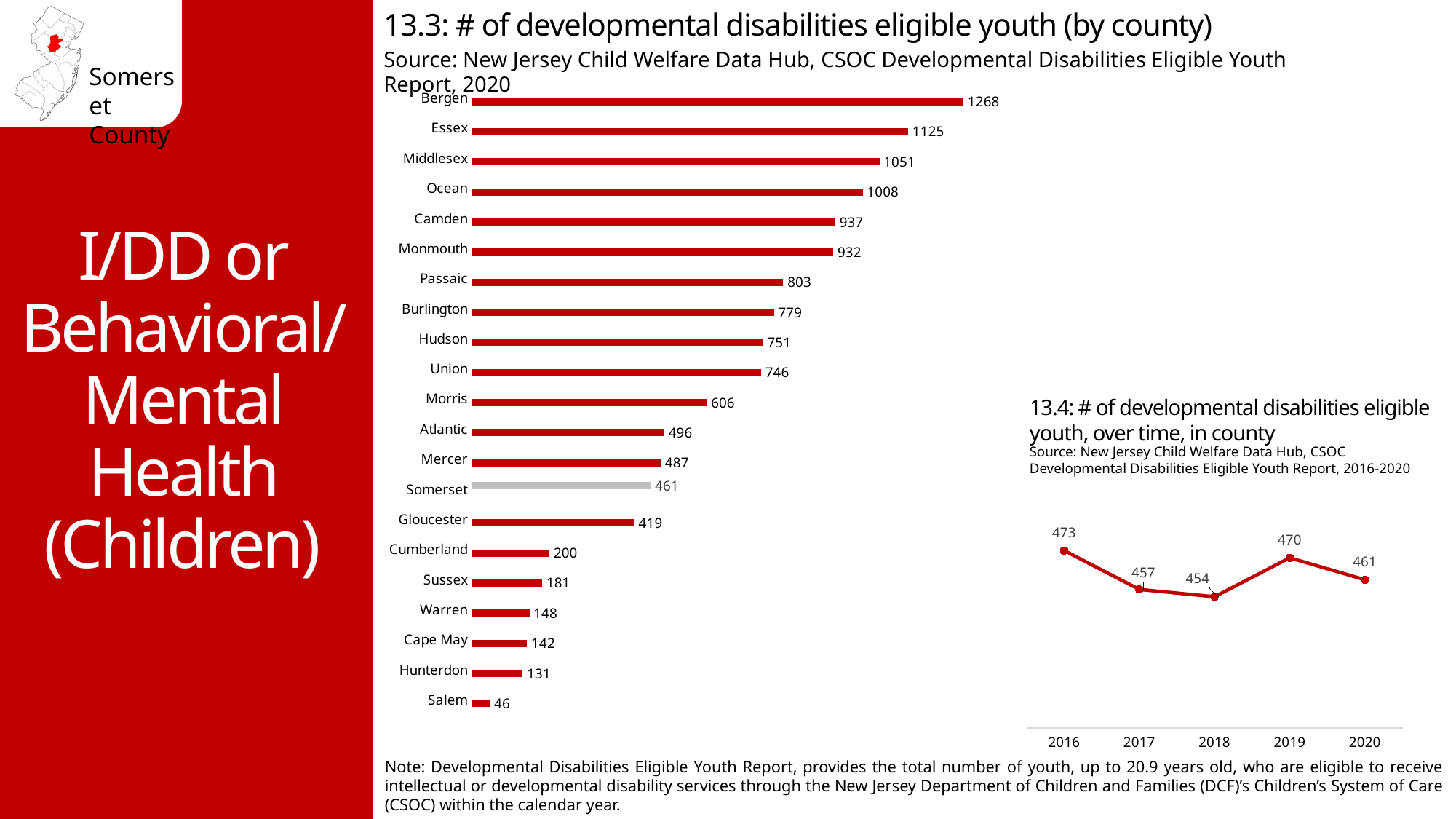
In chart 13.3 (# of developmental disabilities eligible youth by county), which county has the highest value? Bergen In chart 13.4 (# of developmental disabilities eligible youth over time in county), what is the value for 2018? 454 In chart 13.3 (# of developmental disabilities eligible youth by county), which is larger, Passaic or Burlington? Passaic In chart 13.3 (# of developmental disabilities eligible youth by county), what is the value for Hunterdon? 131 In chart 13.3 (# of developmental disabilities eligible youth by county), which county has the lowest value? Salem What kind of chart is chart 13.4 (# of developmental disabilities eligible youth over time in county)? Line chart What kind of chart is chart 13.3 (# of developmental disabilities eligible youth by county)? Bar chart In chart 13.4 (# of developmental disabilities eligible youth over time in county), which year has the highest value? 2016 In chart 13.4 (# of developmental disabilities eligible youth over time in county), what is the difference between 2019 and 2018? 16 In chart 13.3 (# of developmental disabilities eligible youth by county), what is the difference between Bergen and Essex? 143 In chart 13.3 (# of developmental disabilities eligible youth by county), what is the value for Somerset? 461 In chart 13.3 (# of developmental disabilities eligible youth by county), how many counties are shown? 21